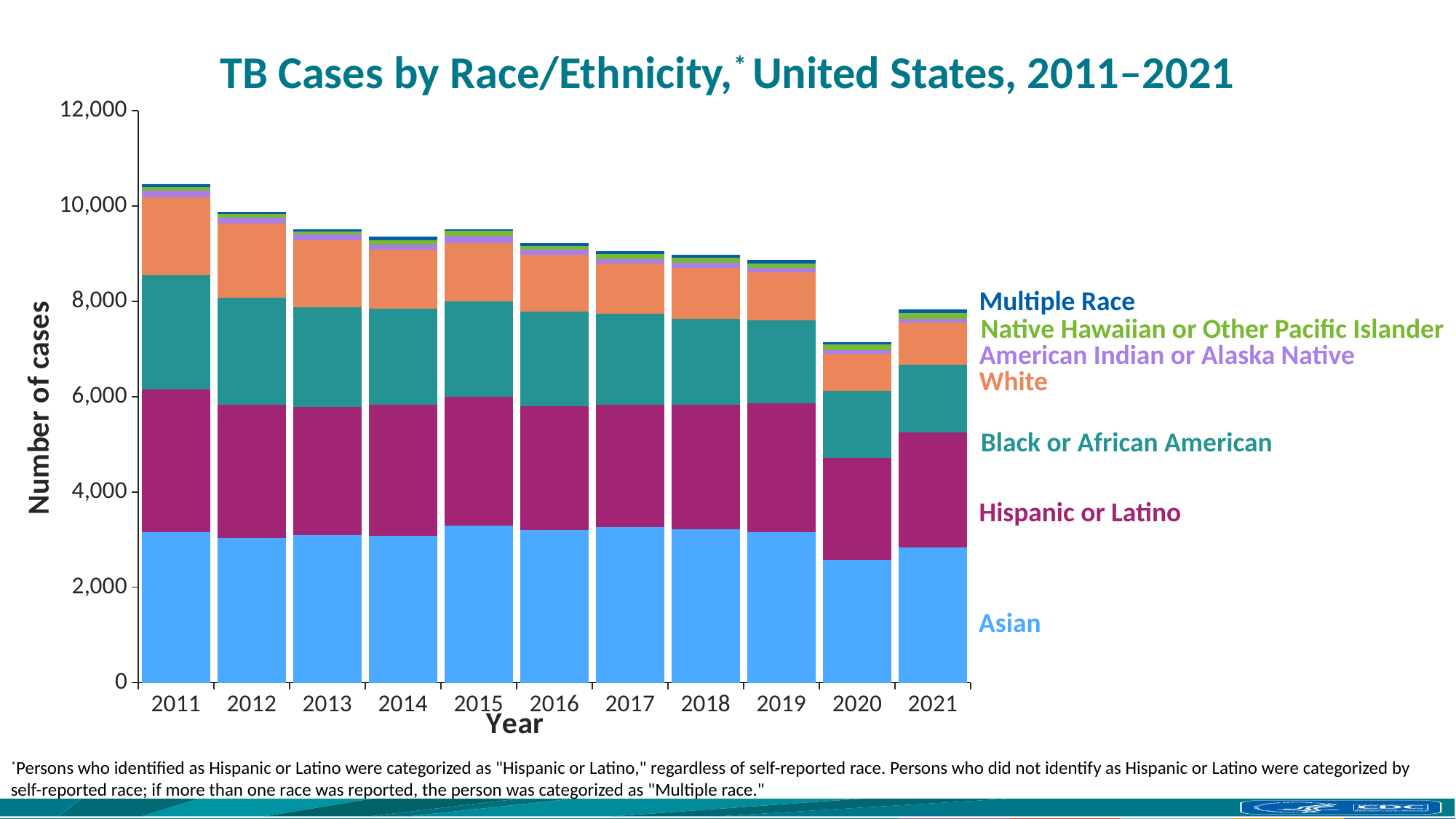
How many race/ethnicity groups does the legend list? 7 What is the title of the chart? TB Cases by Race/Ethnicity, United States, 2011–2021 Is the total number of cases in 2015 greater or less than 9,000? greater Which year has the lowest total number of TB cases? 2020 Is the total number of cases in 2011 greater or less than 10,000? greater Which year has the highest total number of TB cases? 2011 How many years are shown along the x axis? 11 Which race/ethnicity group is shown as the bottom segment of each bar? Asian Which year has a larger total number of cases, 2020 or 2021? 2021 What kind of chart is shown on the slide? Stacked bar chart Do total TB cases generally rise or fall from 2011 to 2020? fall Is the total number of cases in 2020 greater or less than 8,000? less